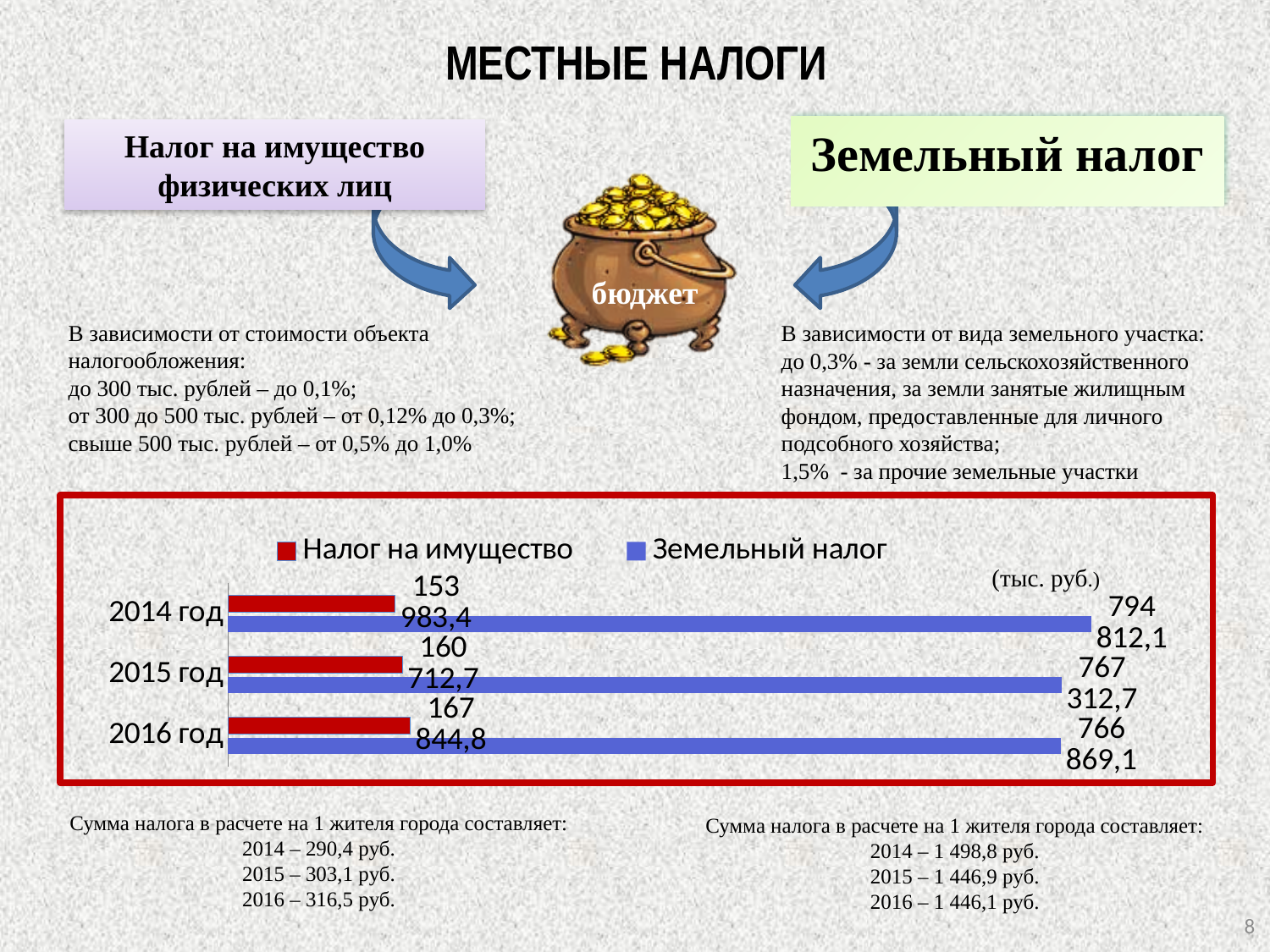
What is the value of Налог на имущество for 2016 год? 167 844,8 Does Налог на имущество rise or fall from 2014 год to 2016 год? rises What is the value of Налог на имущество for 2014 год? 153 983,4 What is the value of Земельный налог for 2016 год? 766 869,1 How many years are shown on the chart? 3 By how much did Налог на имущество increase from 2014 год to 2016 год? 13 861,4 In which year is Налог на имущество the lowest? 2014 год How many series does the legend list? 2 In which year is Земельный налог the highest? 2014 год What is the difference between Земельный налог in 2014 год and 2015 год? 27 499,4 What type of chart is shown on the slide? bar chart For 2015 год, which is larger: Налог на имущество or Земельный налог? Земельный налог